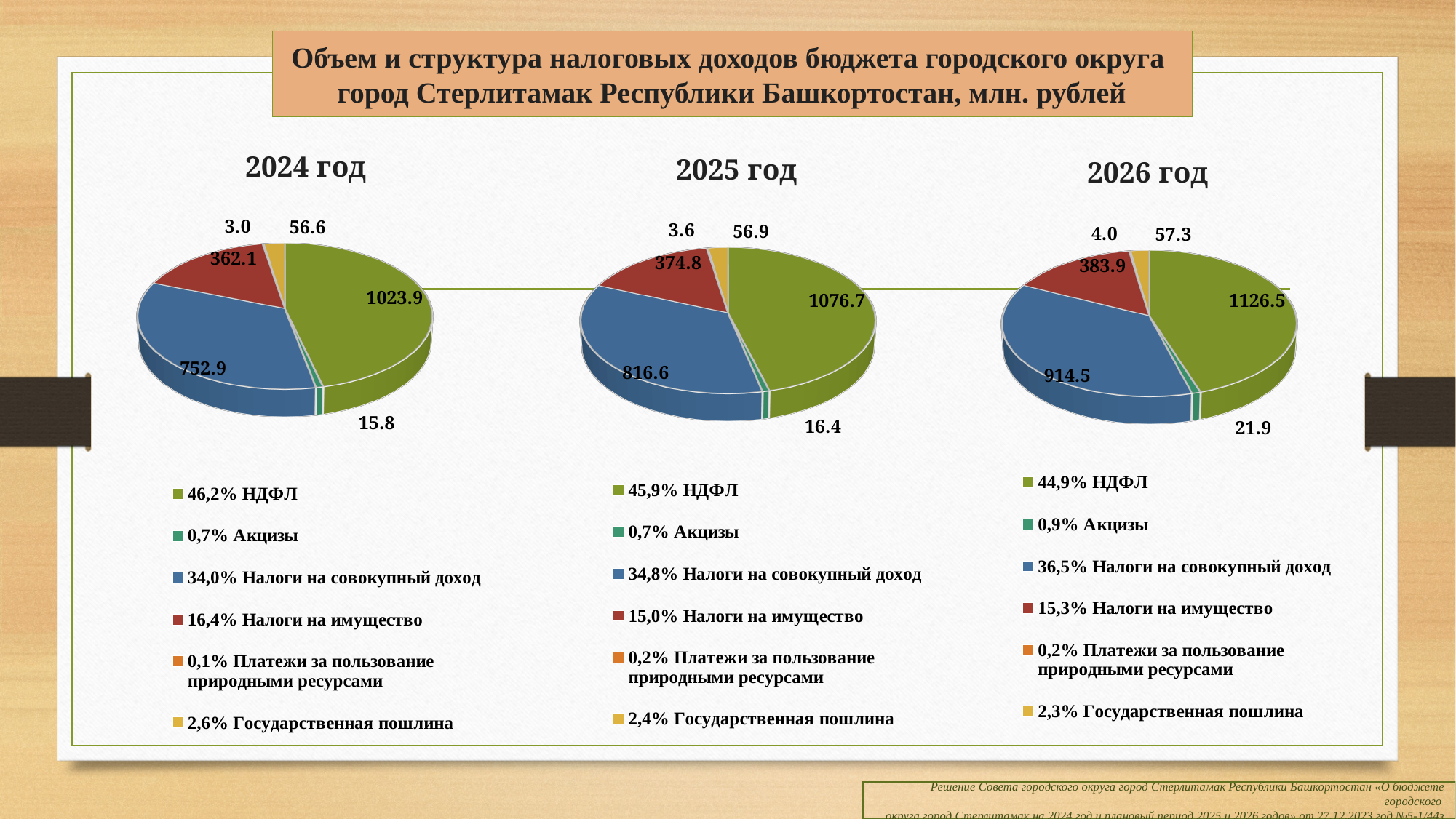
What kind of charts are shown on the slide? Pie charts In the 2024 год chart, what is the value for НДФЛ? 1023.9 Which is larger: Налоги на имущество in the 2024 год chart or Налоги на имущество in the 2025 год chart? 2025 год (374.8) In the 2025 год chart, what is the value for Налоги на совокупный доход? 816.6 In the 2026 год chart, what is the value for Налоги на имущество? 383.9 In the 2024 год chart, what share of the pie does Налоги на совокупный доход represent according to the legend? 34,0% In the 2026 год chart, what is the value for Акцизы? 21.9 What is the difference between the НДФЛ value in the 2026 год chart and the НДФЛ value in the 2024 год chart? 102.6 How many categories does the legend of the 2025 год chart list? 6 Which colour represents Налоги на совокупный доход in the charts? Blue In the 2026 год chart, what share of the pie does Государственная пошлина represent according to the legend? 2,3% In the 2025 год chart, which category has the largest slice? НДФЛ